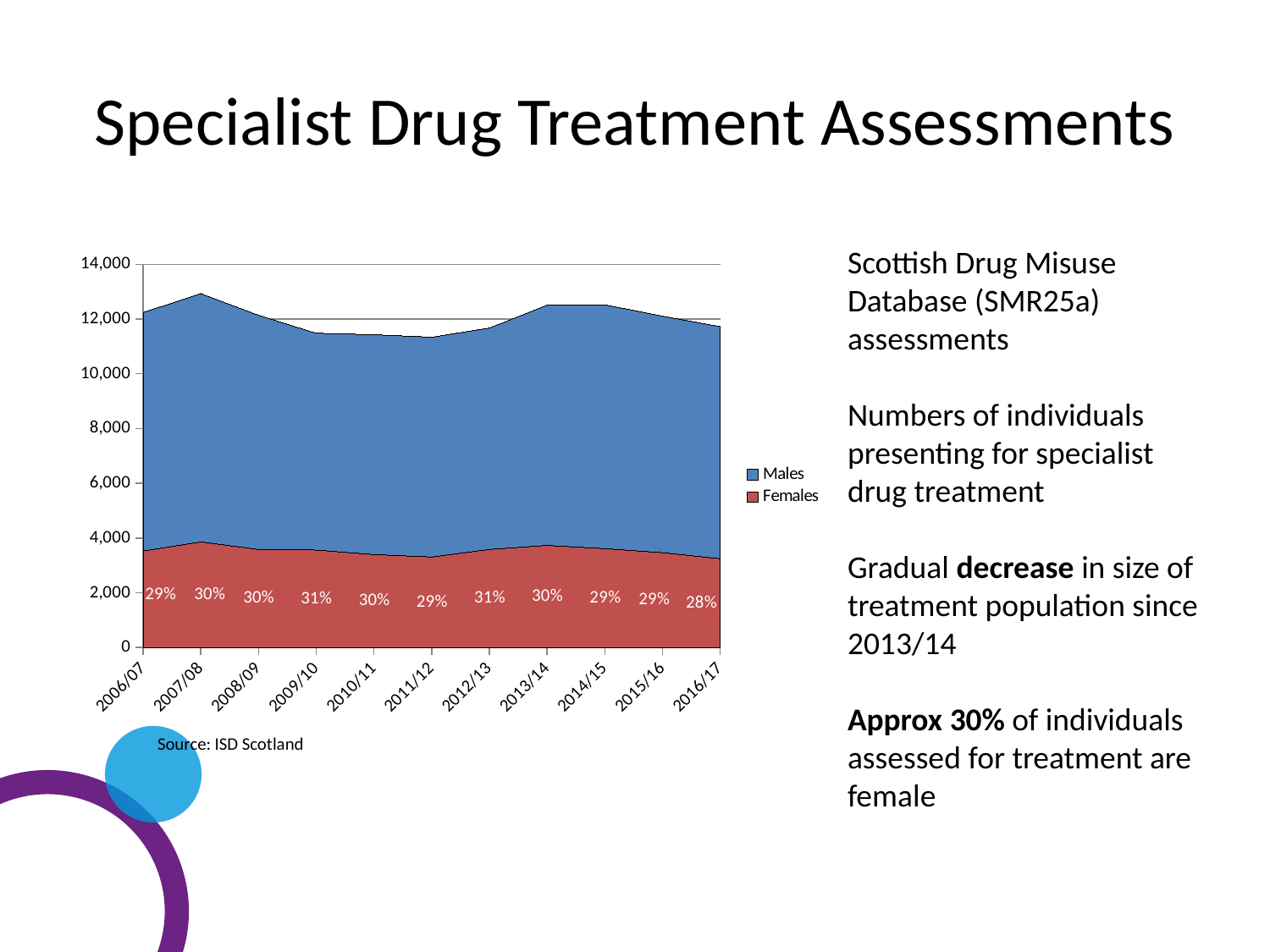
Is the total number of assessments in 2011/12 greater or less than 12,000? less What percentage label is shown for Females in 2016/17? 28% Is the total number of assessments in 2007/08 greater or less than 12,000? greater What kind of chart is shown on the slide? Stacked area chart In which year does the Females percentage label reach its lowest value? 2016/17 What percentage label is shown for Females in 2013/14? 30% How many years are shown on the x axis? 11 What percentage label is shown for Females in 2006/07? 29% Which year has the larger total number of assessments, 2007/08 or 2011/12? 2007/08 Does the total number of assessments rise or fall from 2013/14 to 2016/17? fall How many series does the legend list? 2 What percentage label is shown for Females in 2009/10? 31%